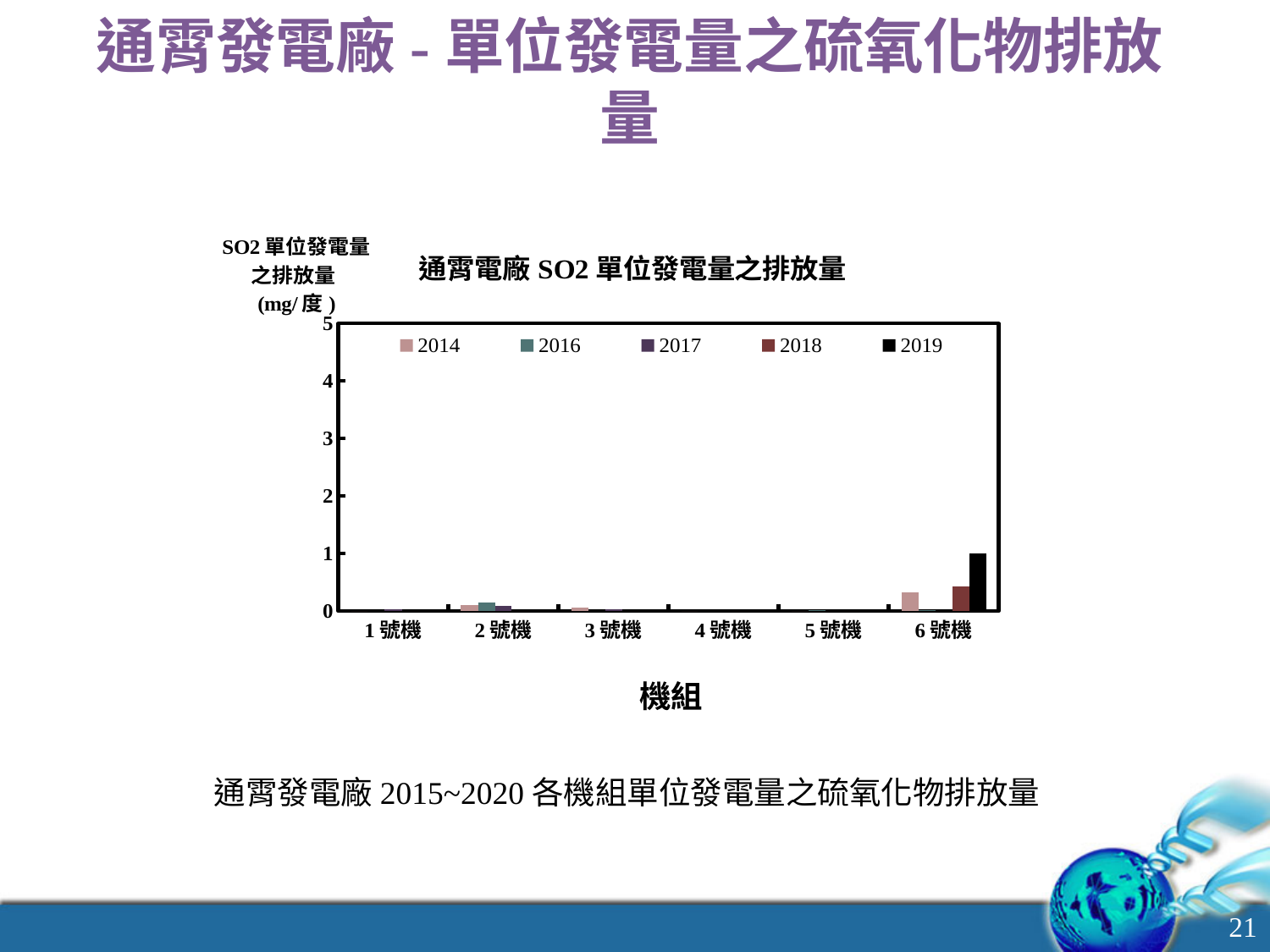
How many units (機組) are shown on the x axis of the chart? 6 What kind of chart is shown on the slide? bar chart For 6 號機, which is larger, the 2019 value or the 2018 value? 2019 Which is larger, the 2014 value for 6 號機 or the 2014 value for 1 號機? 6 號機 How many series does the chart legend list? 5 For 6 號機, which year has the highest bar? 2019 Is the 2018 value for 6 號機 greater or less than 1? less Is the 2019 value for 6 號機 greater or less than 2? less Which unit has the highest SO2 emission bar in the chart? 6 號機 What is the maximum value shown on the y axis of the chart? 5 Which years are listed in the chart legend? 2014, 2016, 2017, 2018, 2019 What is the title of the chart? 通霄電廠 SO2 單位發電量之排放量